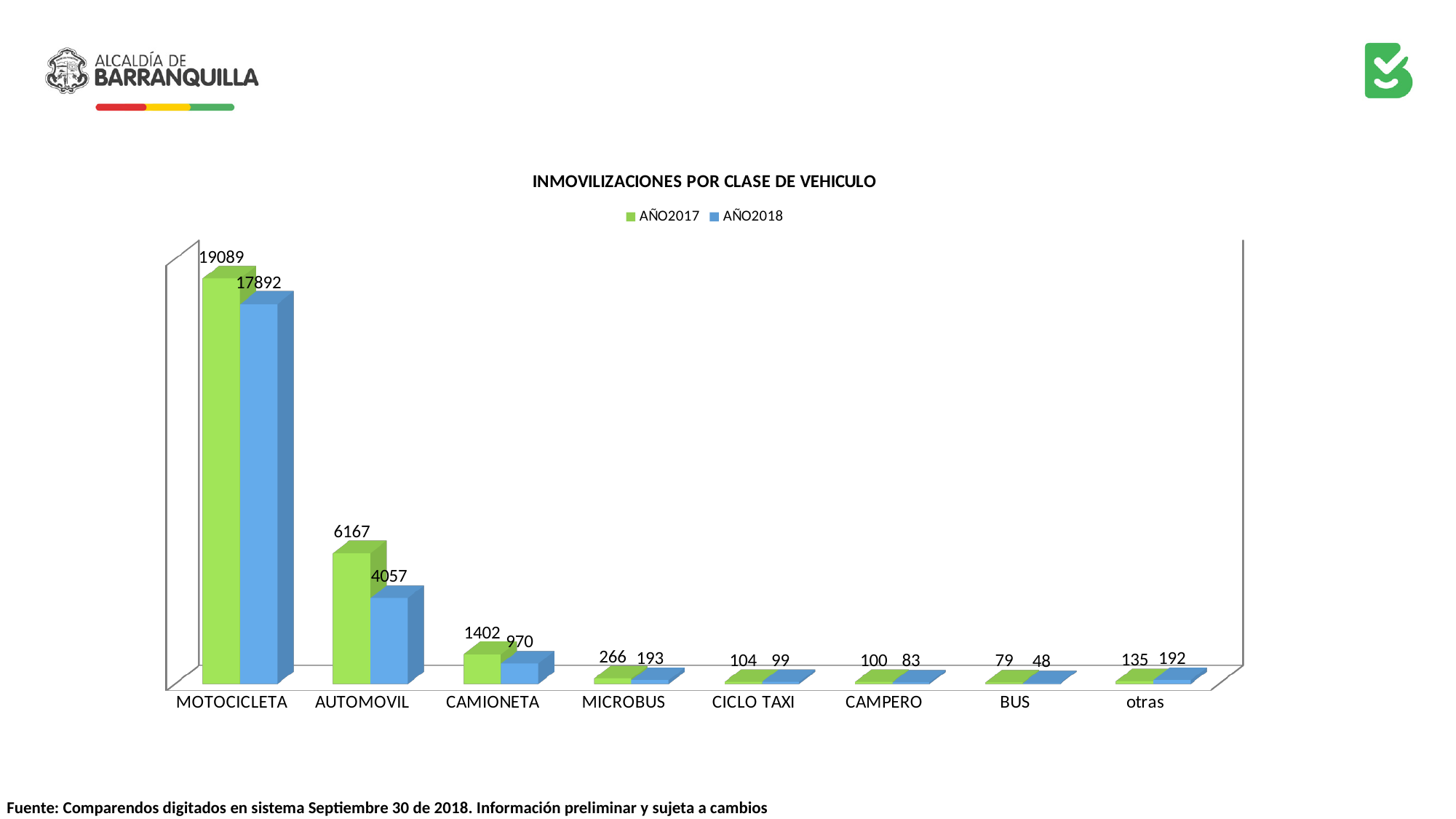
What is the difference between the AÑO2017 and AÑO2018 values for AUTOMOVIL? 2110 Which category has the lowest value in the AÑO2017 series? BUS For the category otras, which series has the larger value, AÑO2017 or AÑO2018? AÑO2018 What is the value for BUS in the AÑO2018 series? 48 What is the value for AUTOMOVIL in the AÑO2018 series? 4057 What is the difference between the AÑO2017 and AÑO2018 values for MOTOCICLETA? 1197 How many vehicle categories are shown on the x axis? 8 How many series does the legend list? 2 Which category has the highest value in the AÑO2018 series? MOTOCICLETA What is the value for CAMIONETA in the AÑO2017 series? 1402 What is the value for MOTOCICLETA in the AÑO2017 series? 19089 What kind of chart is shown on the slide? Bar chart